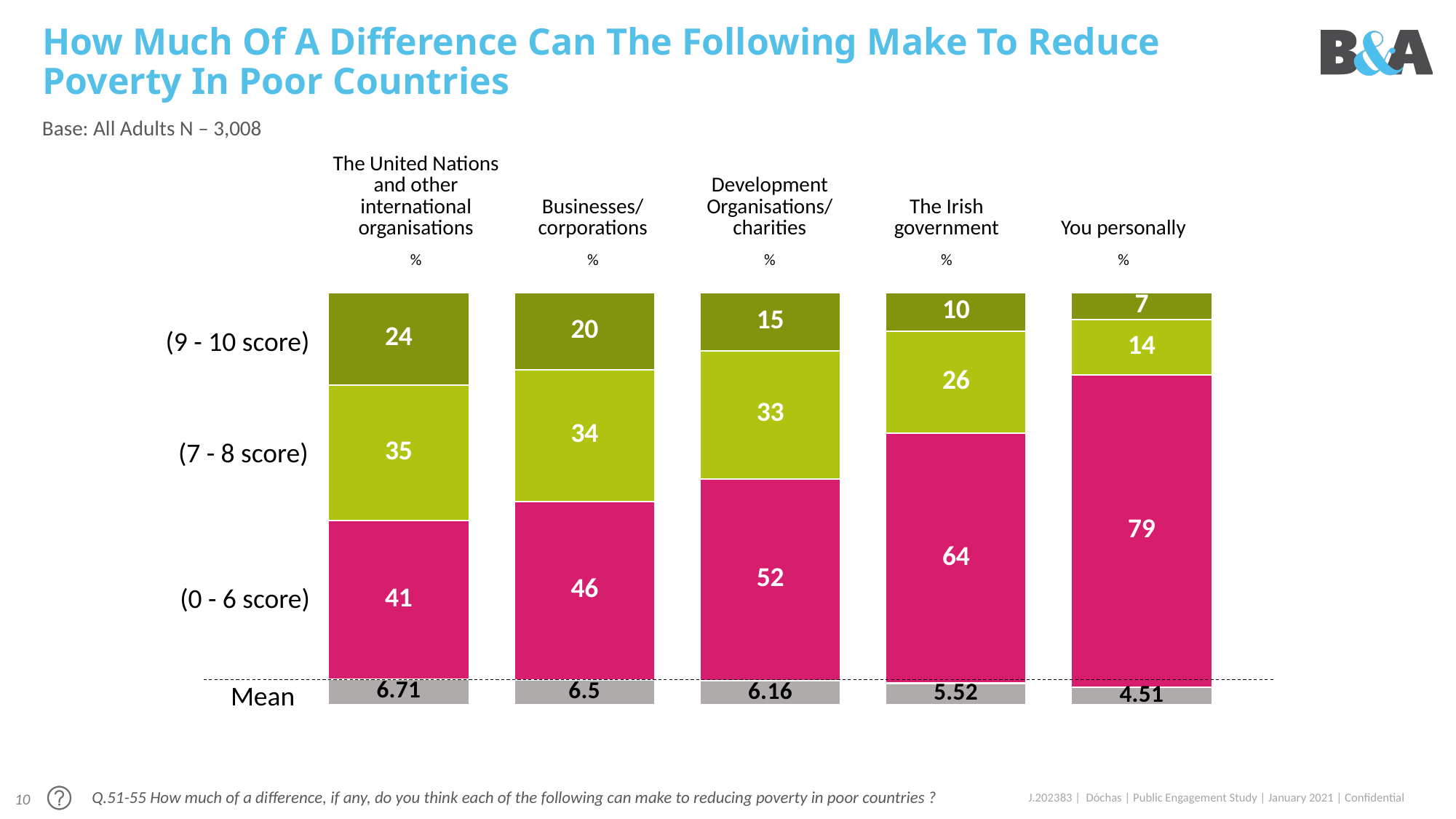
What is the difference between the 0 - 6 score percentage for You personally and for The Irish government? 15 What is the total of the three stacked segments for Businesses/corporations? 100 What is the mean score for The Irish government? 5.52 How many categories are shown in the chart? 5 What kind of chart is shown on the slide? Stacked bar chart What percentage gave Businesses/corporations a 7 - 8 score? 34 Which category has the lowest mean score? You personally Which is larger: the 7 - 8 score percentage for The United Nations and other international organisations or for Development Organisations/charities? The United Nations and other international organisations What percentage gave Development Organisations/charities a 9 - 10 score? 15 Which category has the highest percentage with a 0 - 6 score? You personally Which category has the highest percentage with a 9 - 10 score? The United Nations and other international organisations What is the base sample size stated on the slide? All Adults N – 3,008